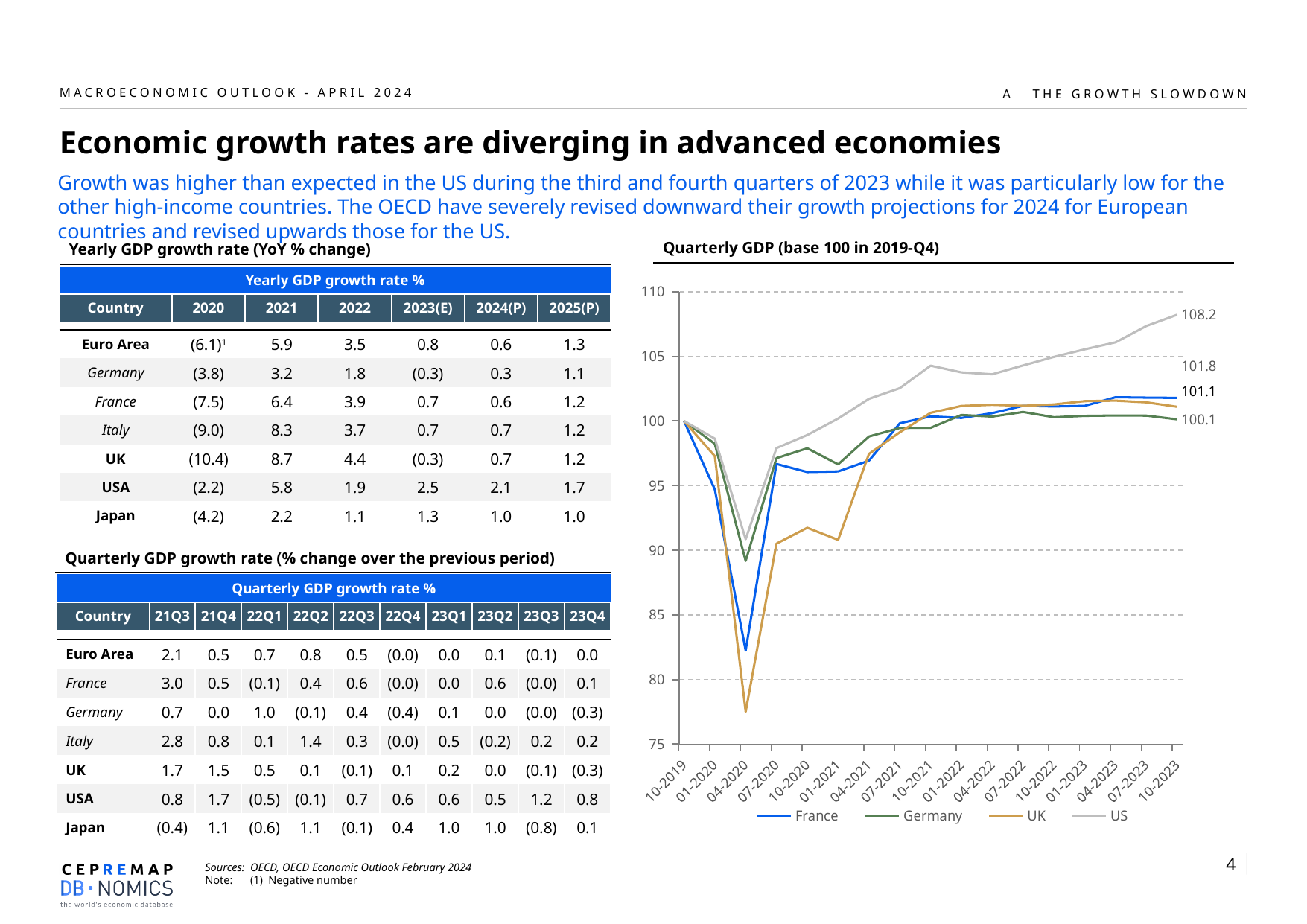
In the Quarterly GDP chart, what is the difference between the US and Germany values at 10-2023? 8.1 In the Quarterly GDP chart, which country has the lowest value at 10-2023? Germany In the Quarterly GDP chart, is the value for the UK at 04-2020 greater or less than 80? less In the Quarterly GDP chart, what is the value for Germany at 10-2023? 100.1 How many quarterly dates are labelled on the x axis of the Quarterly GDP chart? 17 In the Quarterly GDP chart, which country has the highest value at 10-2023? US How many series does the legend of the Quarterly GDP chart list? 4 In the Quarterly GDP chart, does the US series rise or fall from 01-2021 to 10-2023? rise In the Quarterly GDP chart, which is larger at 10-2023, France or the UK? France In the Quarterly GDP chart, is the value for Germany at 04-2020 greater or less than 85? greater What kind of chart is the "Quarterly GDP (base 100 in 2019-Q4)" chart? line chart In the Quarterly GDP chart, what is the value for the US at 10-2023? 108.2